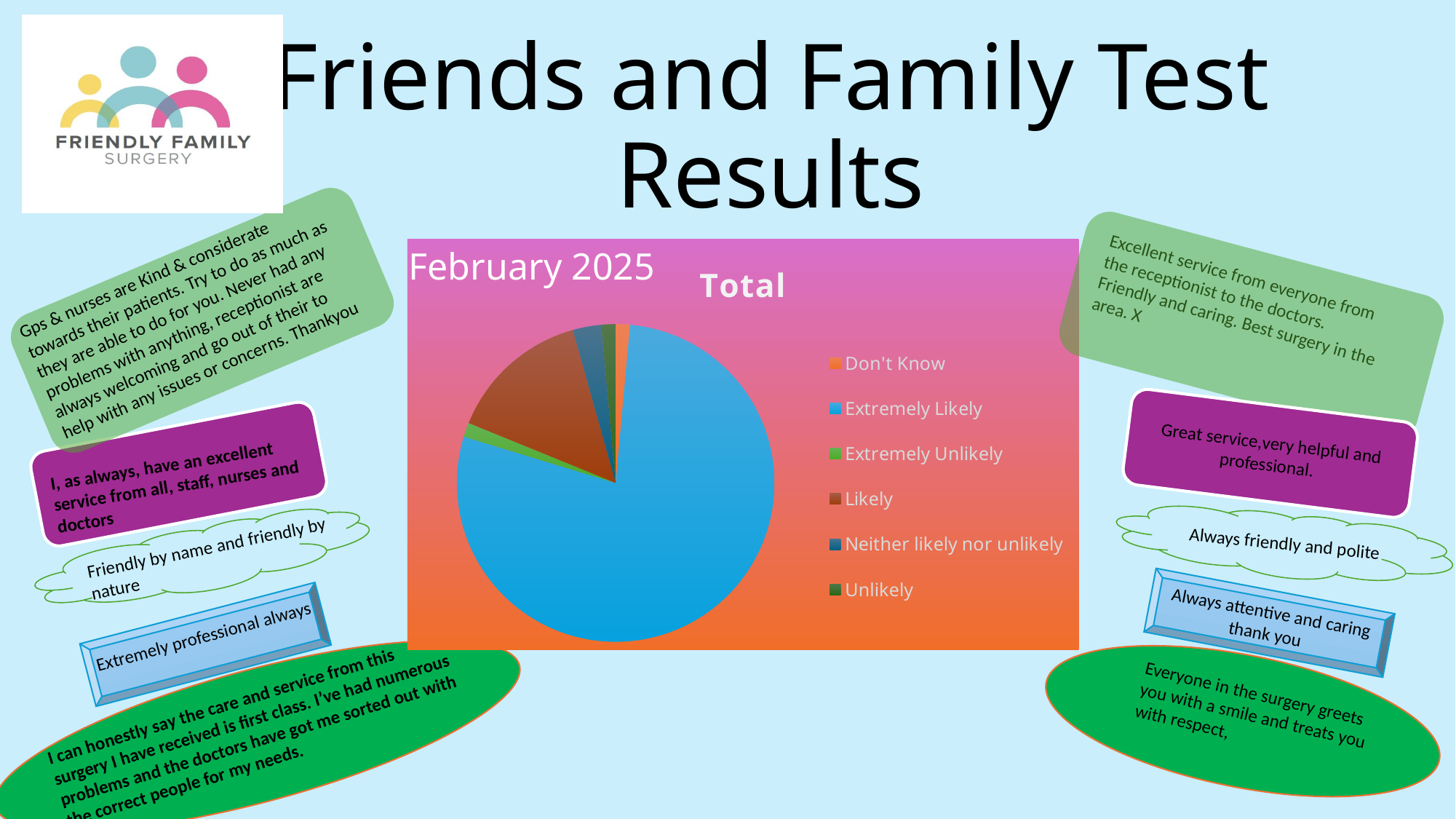
Which slice is larger in the pie chart, Likely or Neither likely nor unlikely? Likely Which category has the largest slice of the pie chart? Extremely Likely Which category has the second-largest slice of the pie chart? Likely Which slice is larger in the pie chart, Likely or Don't Know? Likely What kind of chart is shown on the slide? pie chart How many categories does the pie chart's legend list? 6 What is the title of the pie chart? Total Which slice is larger in the pie chart, Extremely Likely or Likely? Extremely Likely Which month and year does the chart on the slide report results for? February 2025